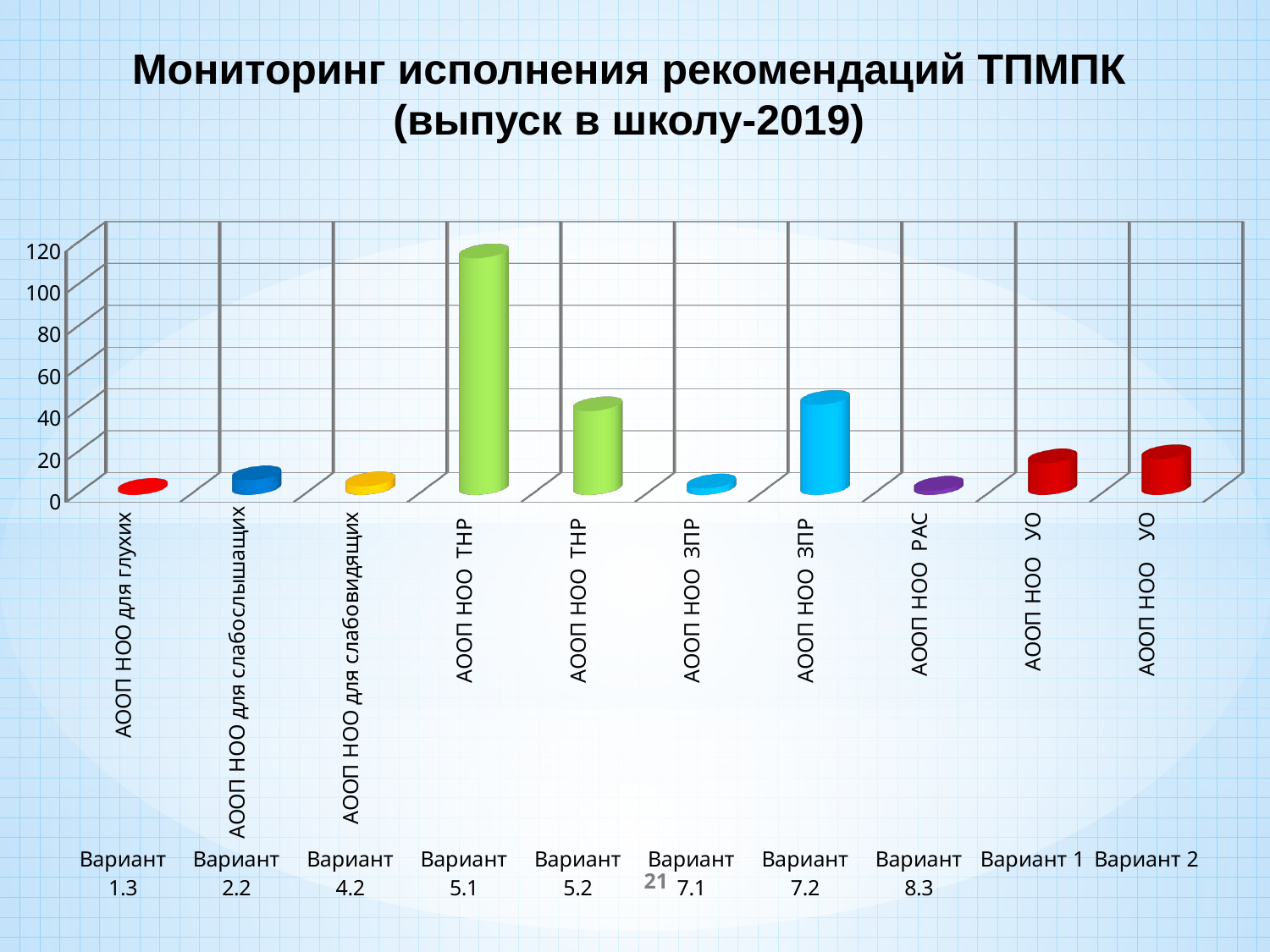
Is the value for Вариант 5.2 (АООП НОО ТНР) greater or less than 20? greater What kind of chart is shown on the slide? bar chart Which variant has the highest bar on the chart? Вариант 5.1 (АООП НОО ТНР) Which is larger, the value for Вариант 5.1 or the value for Вариант 5.2? Вариант 5.1 Is the value for Вариант 7.1 (АООП НОО ЗПР) greater or less than 20? less Which is larger, the value for Вариант 2.2 or the value for Вариант 1.3? Вариант 2.2 What is the title of the slide containing the chart? Мониторинг исполнения рекомендаций ТПМПК (выпуск в школу-2019) Is the value for Вариант 5.1 (АООП НОО ТНР) greater or less than 100? greater How many categories (variants) are plotted on the chart? 10 Which is larger, the value for Вариант 7.2 or the value for Вариант 7.1? Вариант 7.2